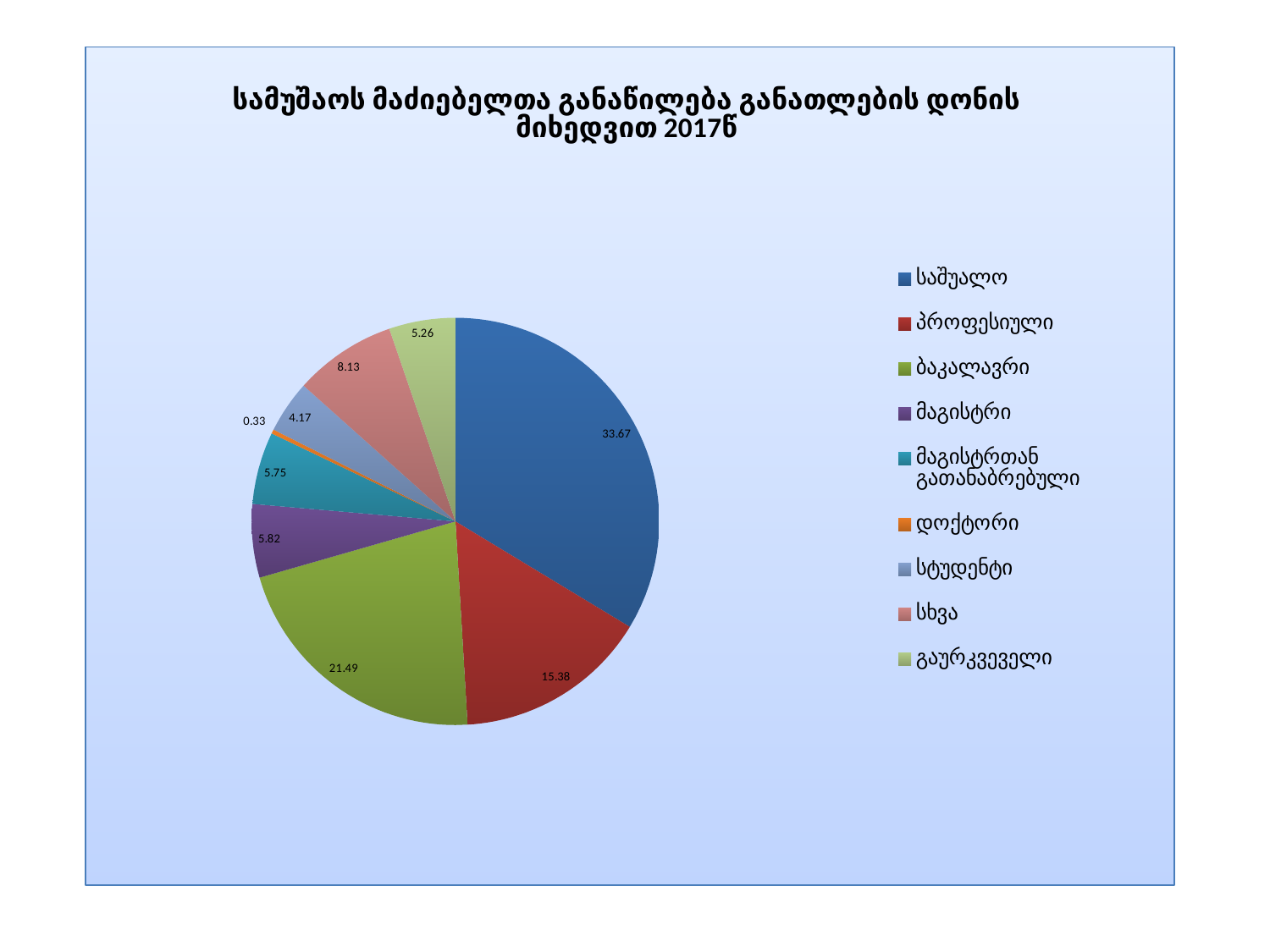
What is the value shown for საშუალო? 33.67 What is the value shown for ბაკალავრი? 21.49 What is the difference between the values for საშუალო and პროფესიული? 18.29 How many categories does the pie chart have? 9 Which category has the largest slice of the pie? საშუალო What colour is the slice for პროფესიული? red Which is larger, the value for სხვა or the value for გაურკვეველი? სხვა What is the value shown for დოქტორი? 0.33 What is the value shown for სხვა? 8.13 Which category has the smallest slice of the pie? დოქტორი What is the difference between the values for ბაკალავრი and სტუდენტი? 17.32 What kind of chart is shown on the slide? pie chart